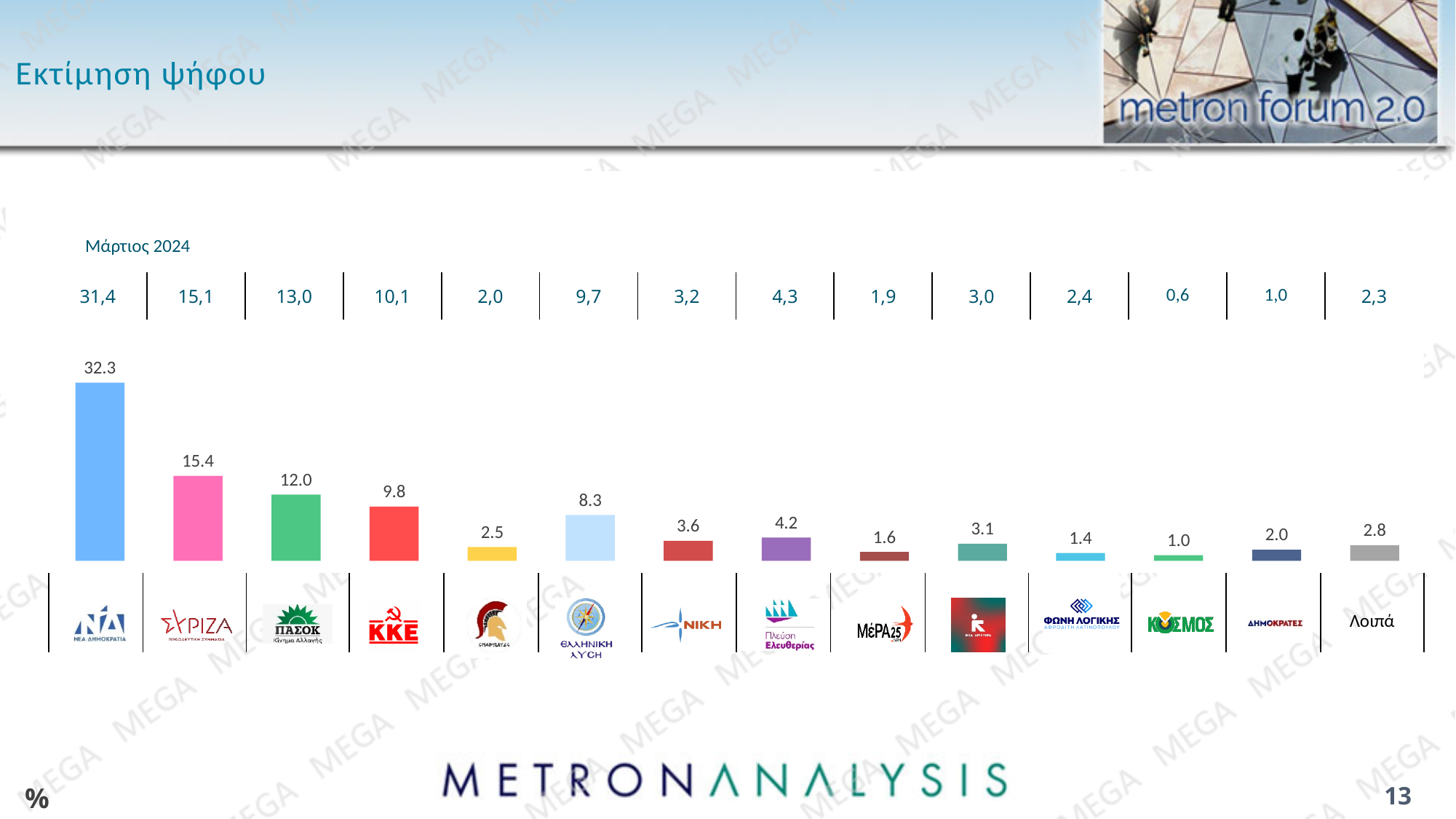
What is the value shown for ΝΕΑ ΔΗΜΟΚΡΑΤΙΑ in the bar chart? 32.3 How many bars are shown in the chart? 14 Which has the larger bar value, ΠΑΣΟΚ or ΚΚΕ? ΠΑΣΟΚ What is the difference between the bar values for ΝΕΑ ΔΗΜΟΚΡΑΤΙΑ and ΣΥΡΙΖΑ? 16.9 What is the value shown for Λοιπά in the bar chart? 2.8 Which party has the lowest bar in the chart? ΚΟΣΜΟΣ What is the value shown for ΚΚΕ in the bar chart? 9.8 What is the value shown for ΕΛΛΗΝΙΚΗ ΛΥΣΗ in the bar chart? 8.3 What is the value shown for ΣΥΡΙΖΑ in the bar chart? 15.4 What kind of chart is shown on the slide? Bar chart What is the Μάρτιος 2024 value listed above the chart for ΝΕΑ ΔΗΜΟΚΡΑΤΙΑ? 31,4 Which party has the highest bar in the chart? ΝΕΑ ΔΗΜΟΚΡΑΤΙΑ